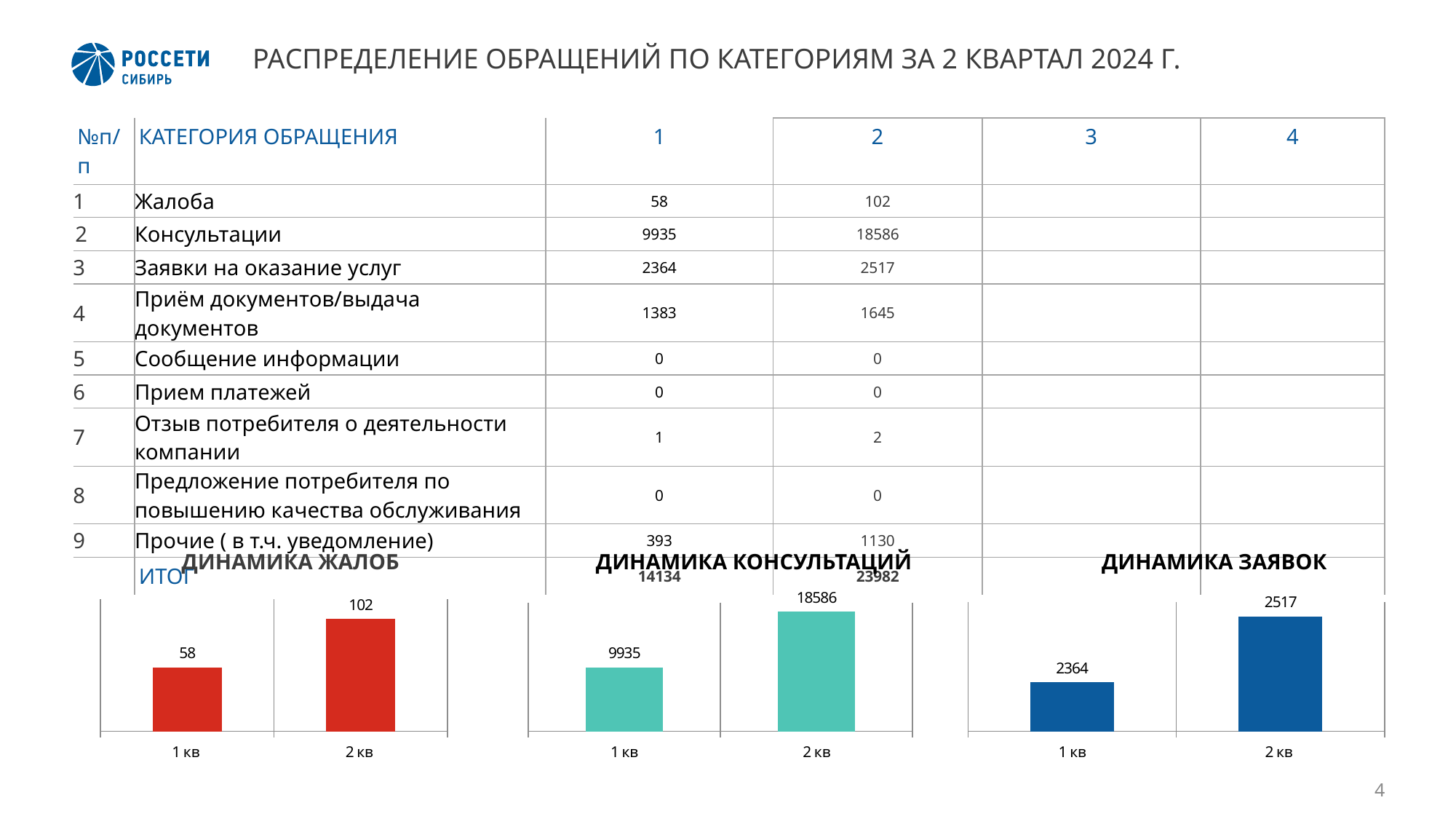
In the chart titled ДИНАМИКА ЗАЯВОК, what is the value for 2 кв? 2517 In the chart titled ДИНАМИКА ЖАЛОБ, do the values rise or fall from 1 кв to 2 кв? rise In the chart titled ДИНАМИКА ЖАЛОБ, what is the difference between the 2 кв and 1 кв values? 44 In the chart titled ДИНАМИКА ЖАЛОБ, what is the value for 2 кв? 102 In the chart titled ДИНАМИКА КОНСУЛЬТАЦИЙ, what is the value for 2 кв? 18586 In the chart titled ДИНАМИКА КОНСУЛЬТАЦИЙ, what is the difference between the 2 кв and 1 кв values? 8651 In the chart titled ДИНАМИКА КОНСУЛЬТАЦИЙ, what is the value for 1 кв? 9935 In the chart titled ДИНАМИКА ЗАЯВОК, which quarter has the lowest value? 1 кв In the chart titled ДИНАМИКА КОНСУЛЬТАЦИЙ, which quarter has the highest value? 2 кв In the chart titled ДИНАМИКА ЗАЯВОК, what is the value for 1 кв? 2364 In the chart titled ДИНАМИКА ЖАЛОБ, what is the value for 1 кв? 58 What kind of chart is the one titled ДИНАМИКА ЗАЯВОК? bar chart